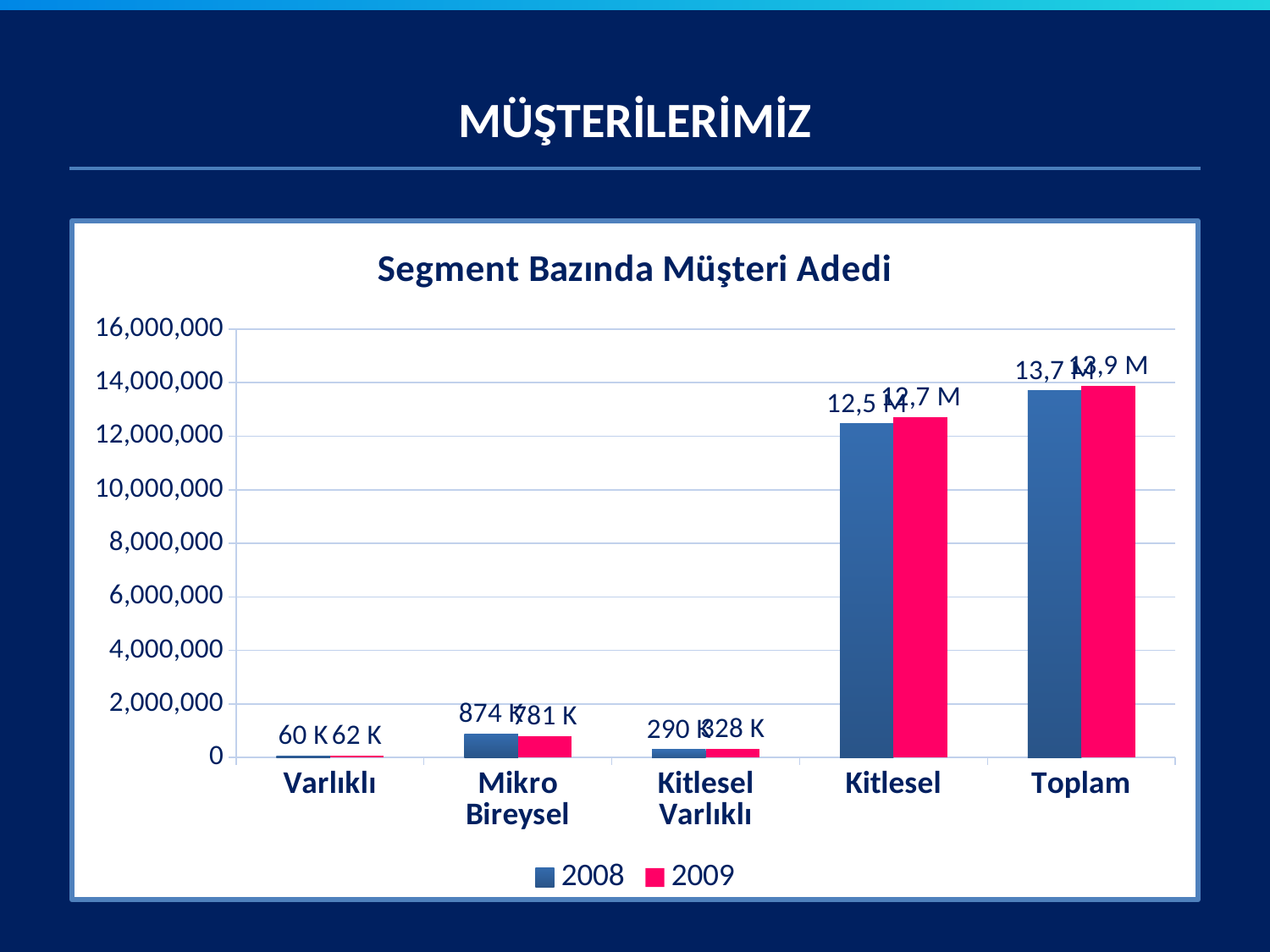
What is the 2009 value for Varlıklı? 62 K What is the difference between the 2008 and 2009 values for Mikro Bireysel? 94 K What is the 2008 value for Kitlesel? 12,5 M What kind of chart is shown on the slide? bar chart Is the 2009 value for Kitlesel greater or less than 12,000,000? greater Which category has the highest 2009 value? Toplam How many series does the legend list? 2 How many segment categories are shown on the x axis? 5 What is the 2008 value for Mikro Bireysel? 874 K What is the 2009 value for Kitlesel Varlıklı? 328 K Which category has the lowest 2008 value? Varlıklı What is the title of the chart? Segment Bazında Müşteri Adedi